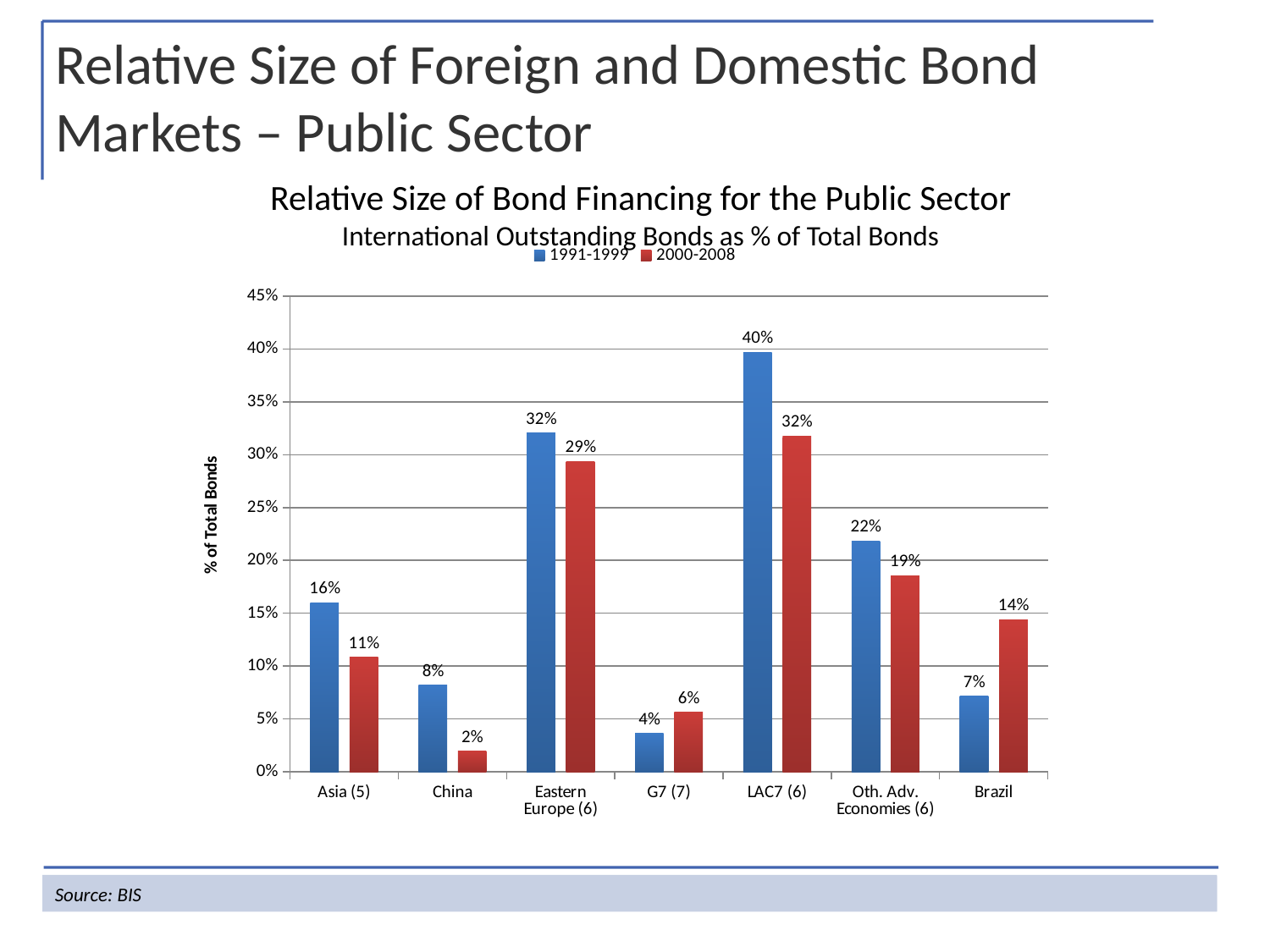
What is the value for LAC7 (6) in the 1991-1999 series? 40% How many series does the legend list? 2 What is the value for Brazil in the 2000-2008 series? 14% What kind of chart is shown on the slide? Bar chart What is the difference between the 1991-1999 and 2000-2008 values for Asia (5)? 5% Is the 1991-1999 value for Eastern Europe (6) greater or less than 30%? greater What is the value for China in the 2000-2008 series? 2% Which category has the lowest value in the 2000-2008 series? China How many categories are shown on the x axis? 7 Which category has the highest value in the 1991-1999 series? LAC7 (6) Which is larger for G7 (7): the 1991-1999 value or the 2000-2008 value? 2000-2008 What is the label of the vertical axis? % of Total Bonds